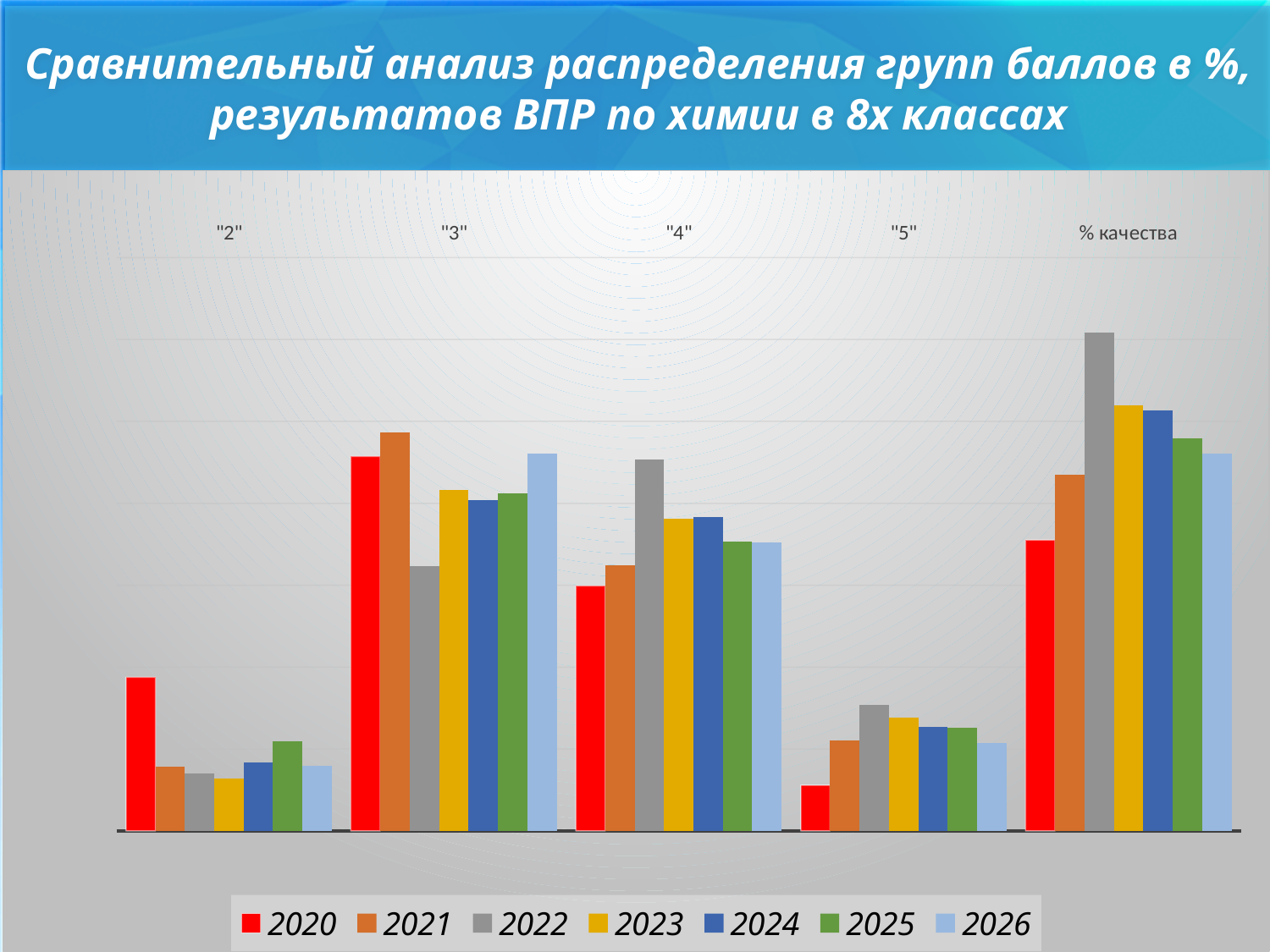
In the "3" category, which year has the lowest bar? 2022 In the "% качества" category, which year has the highest bar? 2022 In the "4" category, which year has the highest bar? 2022 In the "3" category, which is larger: the bar for 2026 or the bar for 2022? 2026 In the "3" category, which year has the highest bar? 2021 What kind of chart is shown on the slide? bar chart In the "5" category, which year has the lowest bar? 2020 In the "% качества" category, which year has the lowest bar? 2020 How many series does the legend list? 7 Which year is listed first in the legend? 2020 How many categories are shown along the x axis? 5